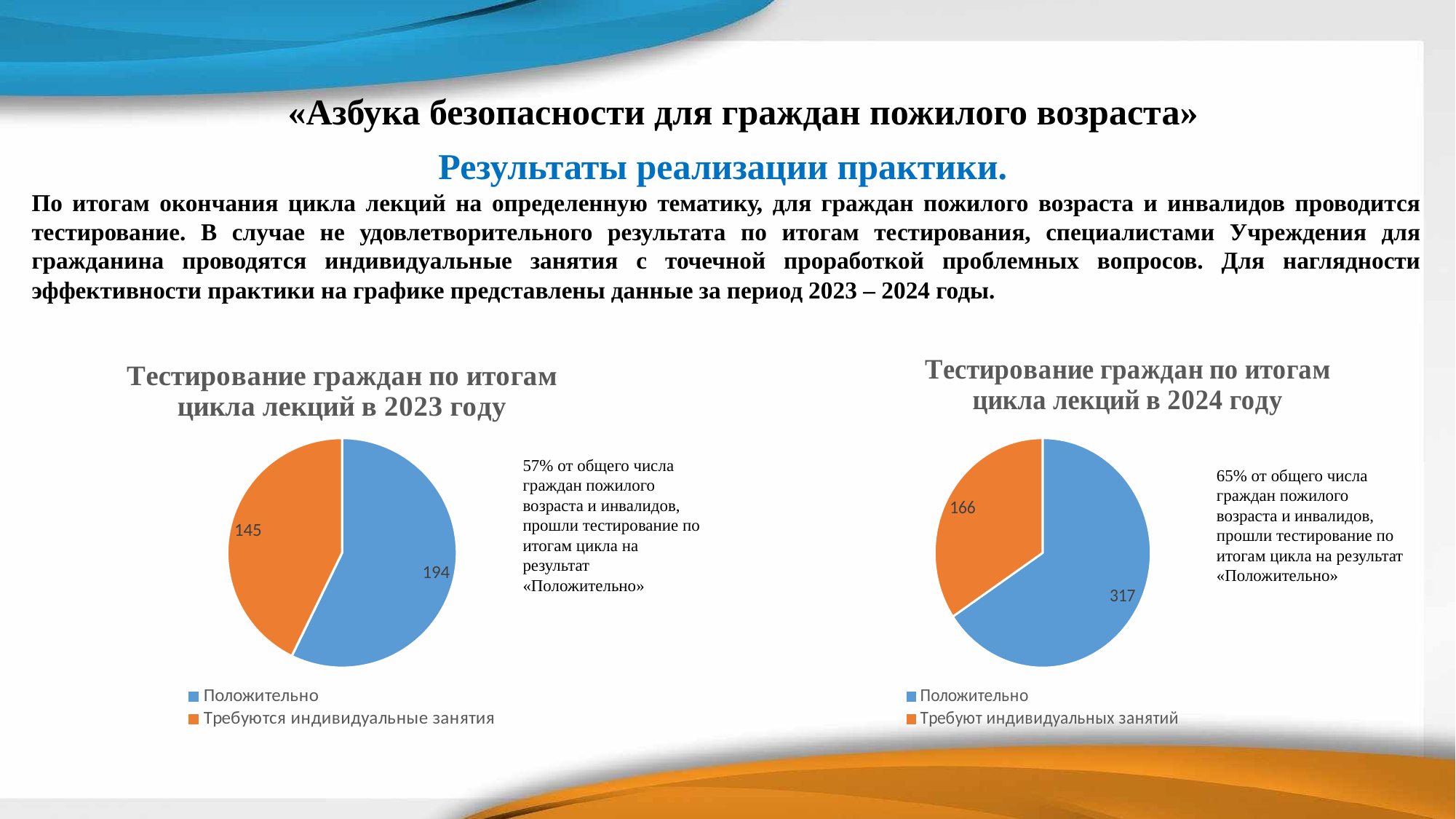
How many categories does the legend of the 2023 chart list? 2 In the 2024 chart, which category has the smallest slice? Требуют индивидуальных занятий What is the total of all slices in the 2024 chart? 483 In the 2024 chart, what is the value for "Положительно"? 317 What type of chart is used on the left, titled "Тестирование граждан по итогам цикла лекций в 2023 году"? Pie chart In the 2023 chart, what is the value for "Положительно"? 194 In the 2024 chart, what is the difference between "Положительно" and "Требуют индивидуальных занятий"? 151 According to the slide, what share of citizens tested "Положительно" in the 2023 chart? 57% In the 2023 chart, which category has the largest slice? Положительно In the 2023 chart, what is the difference between "Положительно" and "Требуются индивидуальные занятия"? 49 In the 2024 chart, what is the value for "Требуют индивидуальных занятий"? 166 In the 2023 chart, what is the value for "Требуются индивидуальные занятия"? 145